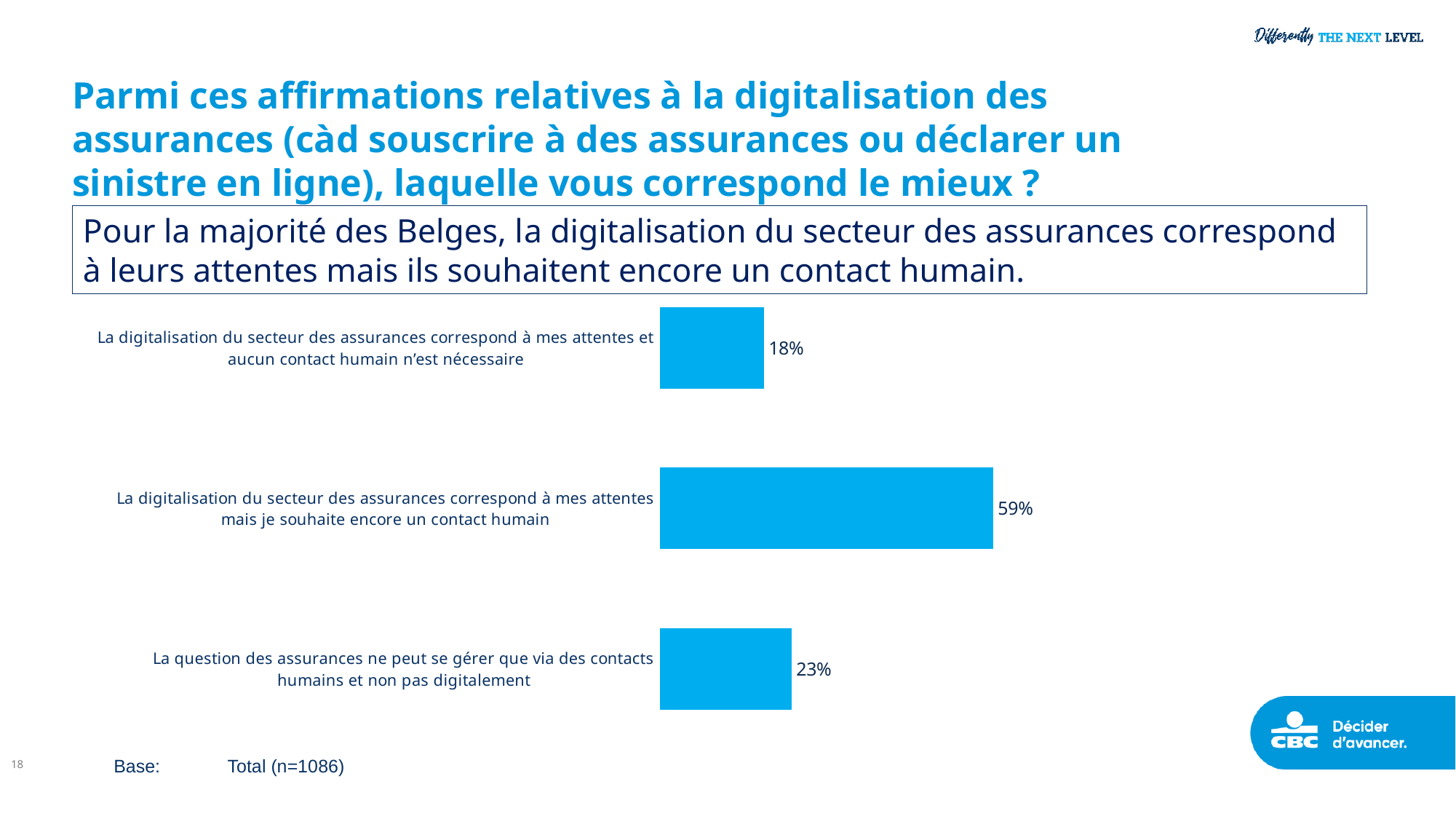
What is the value for "La digitalisation du secteur des assurances correspond à mes attentes et aucun contact humain n'est nécessaire"? 18% What is the base (sample size) indicated at the bottom of the slide? Total (n=1086) What is the difference between the highest value (59%) and the lowest value (18%)? 41 percentage points Which is larger: the value for "La question des assurances ne peut se gérer que via des contacts humains et non pas digitalement" or the value for "...aucun contact humain n'est nécessaire"? La question des assurances ne peut se gérer que via des contacts humains et non pas digitalement Which statement has the highest percentage? La digitalisation du secteur des assurances correspond à mes attentes mais je souhaite encore un contact humain How many statements (categories) are shown in the chart? 3 What is the difference between the value for "La question des assurances ne peut se gérer que via des contacts humains et non pas digitalement" and the value for "...aucun contact humain n'est nécessaire"? 5 percentage points What is the value for "La question des assurances ne peut se gérer que via des contacts humains et non pas digitalement"? 23% What percentage of respondents chose "La digitalisation du secteur des assurances correspond à mes attentes mais je souhaite encore un contact humain"? 59% What colour are the bars in the chart? Light blue Which statement has the lowest percentage? La digitalisation du secteur des assurances correspond à mes attentes et aucun contact humain n'est nécessaire What kind of chart is shown on the slide? Bar chart